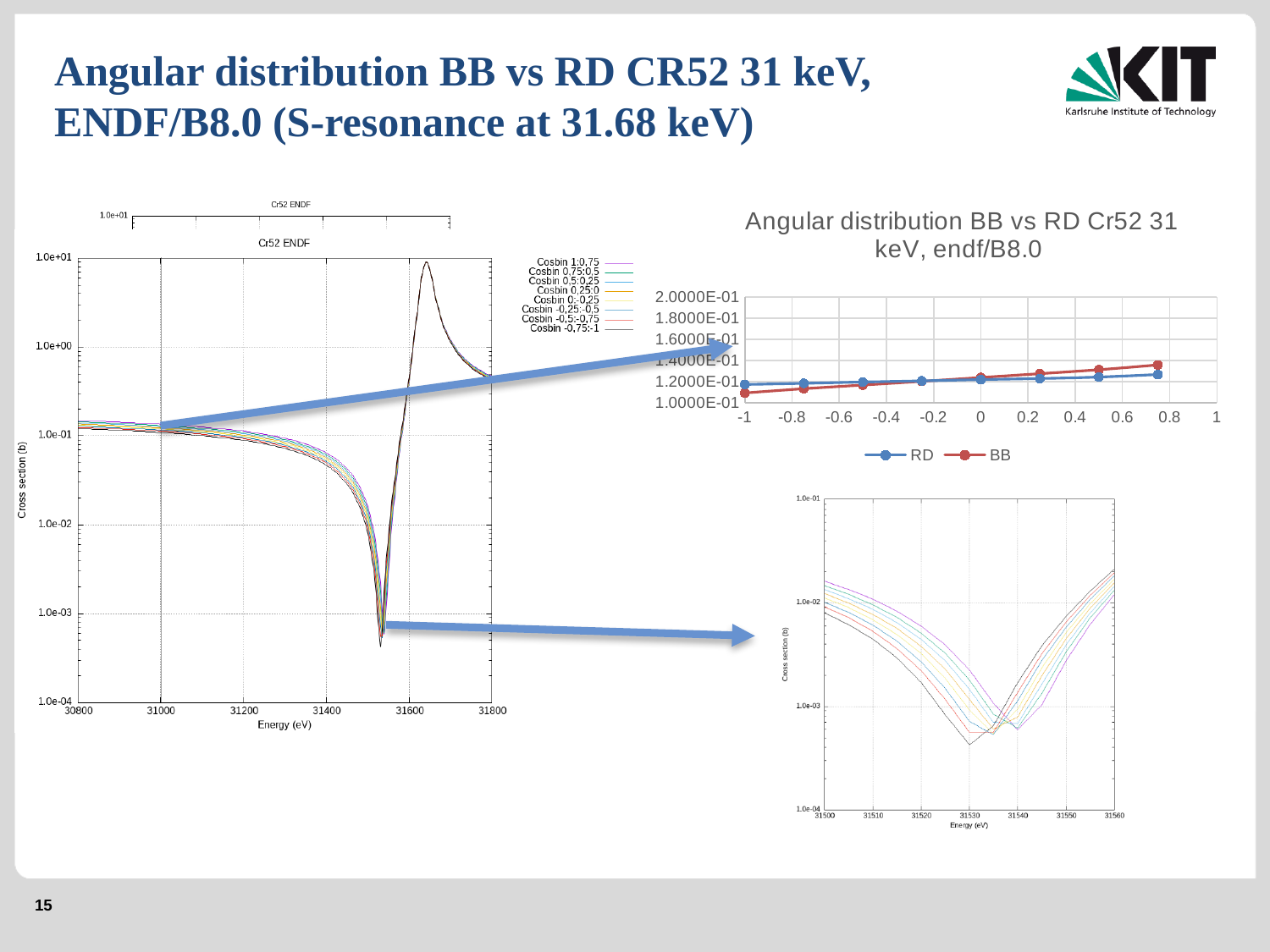
In the chart titled "Angular distribution BB vs RD Cr52 31 keV, endf/B8.0", what are the names of the two series in the legend? RD and BB In the chart titled "Angular distribution BB vs RD Cr52 31 keV, endf/B8.0", is the BB value at x = 0.75 greater or less than 1.2000E-01? greater In the chart titled "Angular distribution BB vs RD Cr52 31 keV, endf/B8.0", which series has the larger value at x = -1, RD or BB? RD In the chart titled "Angular distribution BB vs RD Cr52 31 keV, endf/B8.0", is the BB value at x = -1 greater or less than 1.2000E-01? less In the chart titled "Angular distribution BB vs RD Cr52 31 keV, endf/B8.0", does the BB series rise or fall as the x value increases from -1 to 0.75? Rise In the large chart on the left titled "Cr52 ENDF", how many Cosbin series does the legend list? 8 In the chart titled "Angular distribution BB vs RD Cr52 31 keV, endf/B8.0", is the RD value at x = 0.75 greater or less than 1.4000E-01? less What kind of chart is the "Angular distribution BB vs RD Cr52 31 keV, endf/B8.0" chart? Line chart In the chart titled "Angular distribution BB vs RD Cr52 31 keV, endf/B8.0", how many data points does the BB series have? 8 In the chart titled "Angular distribution BB vs RD Cr52 31 keV, endf/B8.0", which series has the larger value at x = 0.75, RD or BB? BB In the chart titled "Angular distribution BB vs RD Cr52 31 keV, endf/B8.0", how many series does the legend list? 2 In the large chart on the left titled "Cr52 ENDF", what is the label of the x axis? Energy (eV)